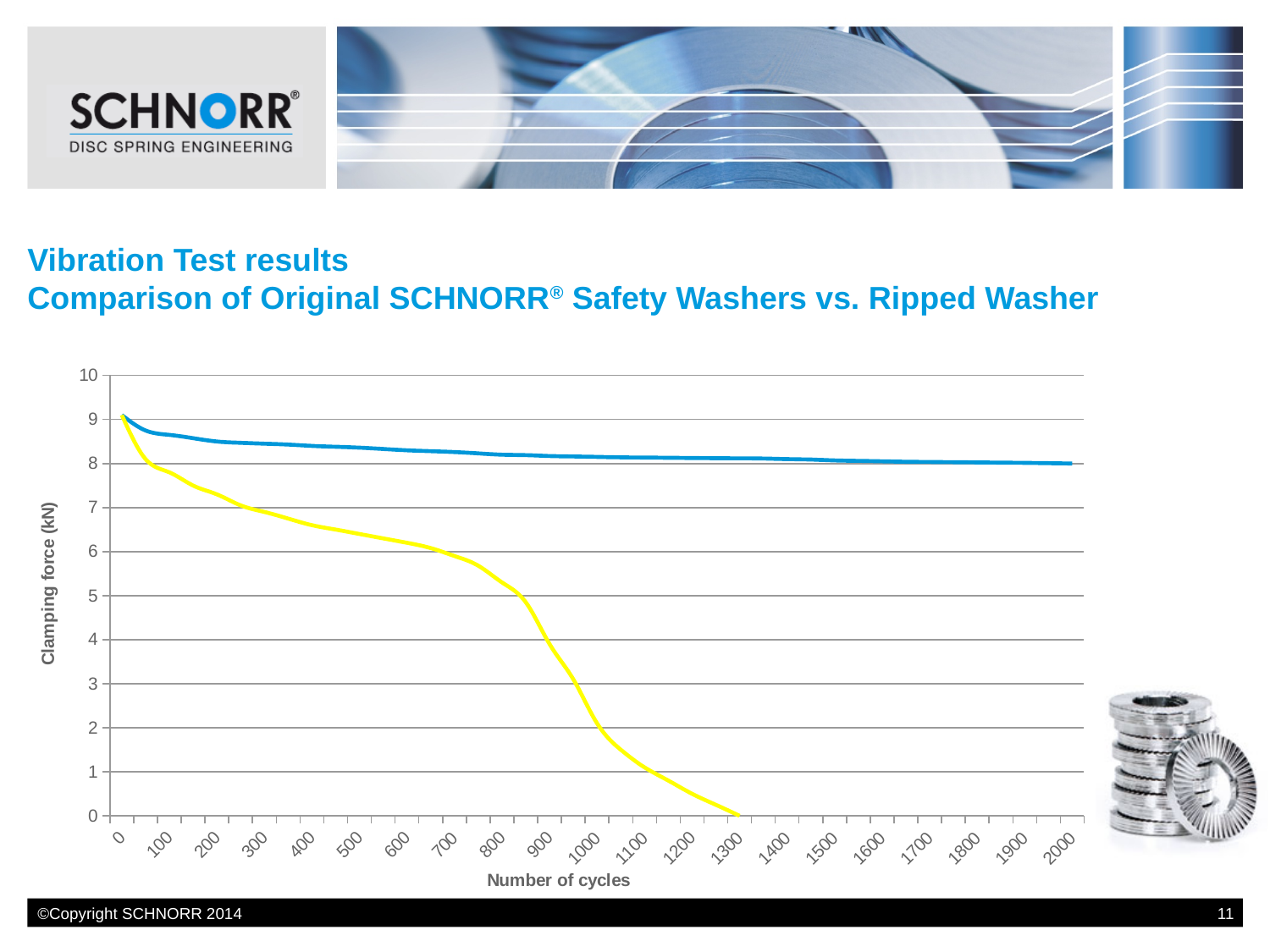
Does the yellow line rise or fall as the number of cycles increases? fall Is the clamping force of the yellow line at 1200 cycles greater or less than 1 kN? less Is the clamping force of the yellow line at 200 cycles greater or less than 7 kN? greater At 1000 cycles, which line shows the higher clamping force, the blue line or the yellow line? blue line What kind of chart is shown on the slide? line chart How many lines are plotted on the chart? 2 Is the clamping force of the yellow line at 800 cycles greater or less than 6 kN? less What is the label of the horizontal axis? Number of cycles Does the blue line rise or fall as the number of cycles increases? fall What is the label of the vertical axis? Clamping force (kN)